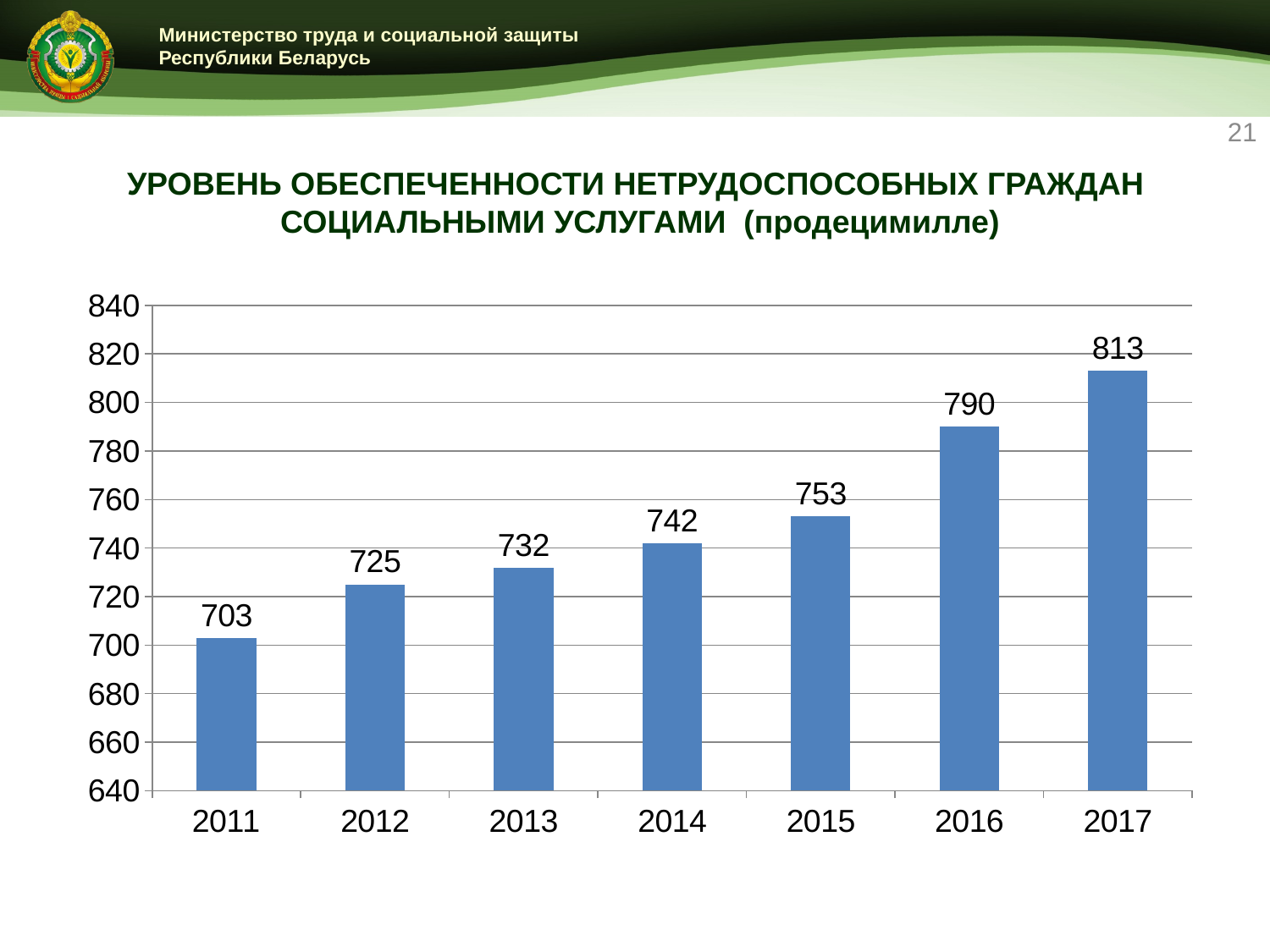
Which year has the highest value? 2017 What is the difference between the values for 2016 and 2015? 37 Do the values rise or fall from 2011 to 2017? rise Which is larger, the value for 2013 or the value for 2014? 2014 What is the value for 2011? 703 What is the value for 2017? 813 What is the difference between the values for 2017 and 2011? 110 Which year has the lowest value? 2011 What kind of chart is shown on the slide? bar chart How many years are shown on the x axis? 7 What is the value for 2015? 753 Is the value for 2016 greater or less than 780? greater